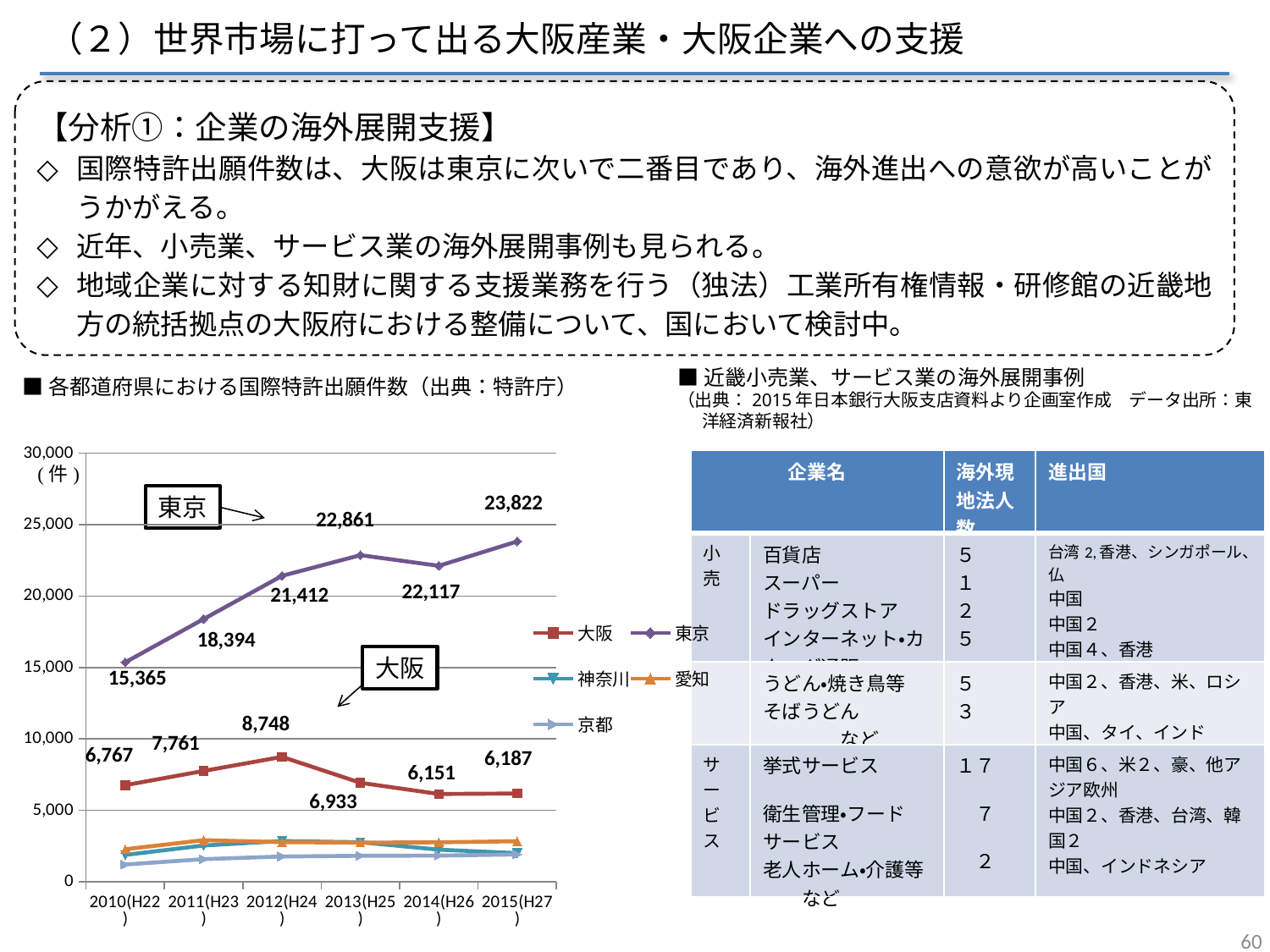
Does the 東京 series generally rise or fall from 2010(H22) to 2015(H27)? rise How many series does the chart legend list? 5 Is the value for 京都 in 2015(H27) greater or less than 5,000? less What is the value for 東京 in 2010(H22)? 15,365 In which year does 東京 have its lowest value? 2010(H22) What is the difference between the 東京 values in 2015(H27) and 2010(H22)? 8,457 How many years are plotted along the x axis of the chart? 6 In which year does 大阪 reach its highest value? 2012(H24) Which series has the larger value in 2013(H25), 東京 or 大阪? 東京 What is the value for 東京 in 2015(H27)? 23,822 What is the value for 大阪 in 2012(H24)? 8,748 What type of chart is shown on the slide? line chart